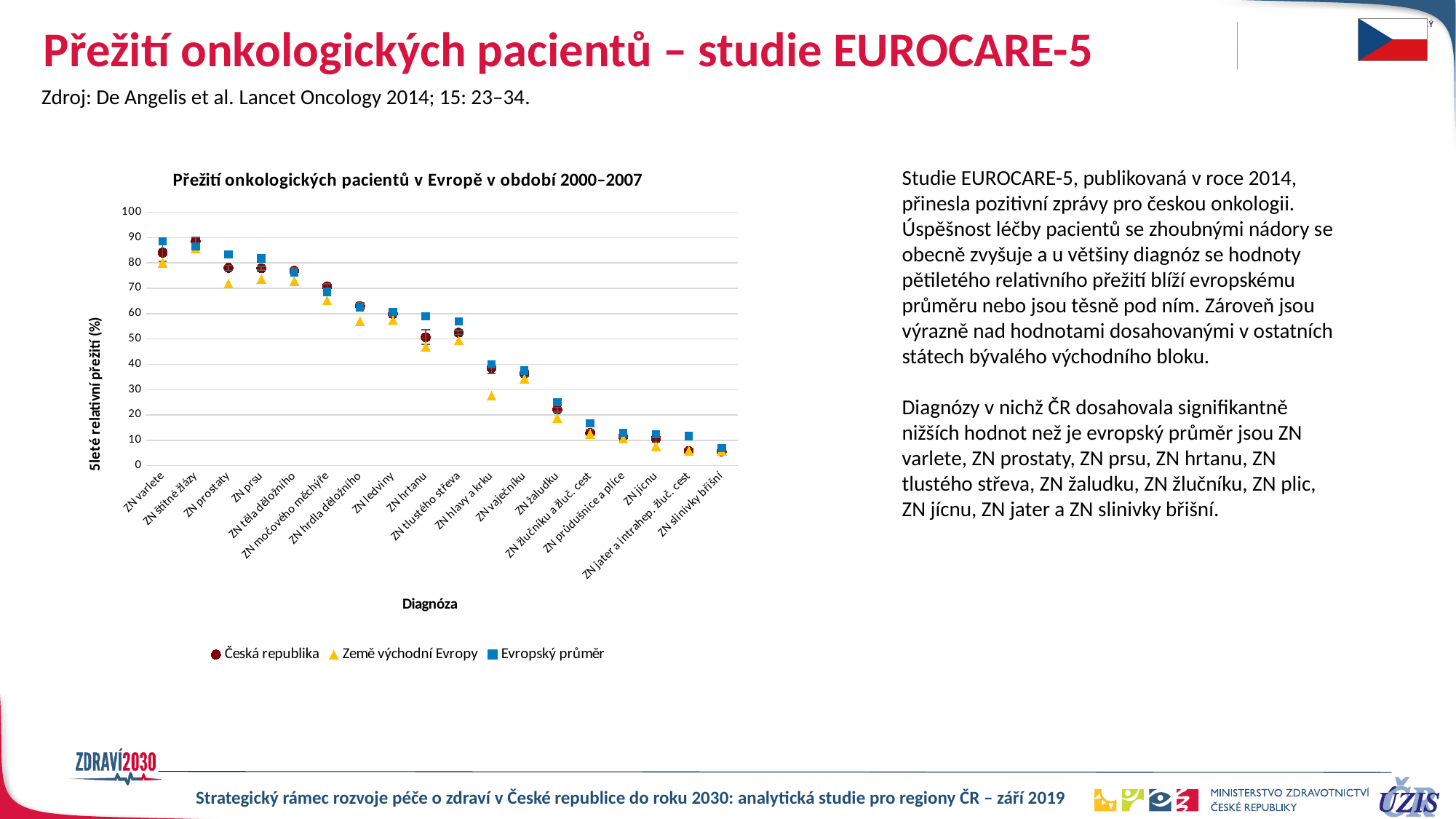
What is the label of the vertical axis of the chart? 5leté relativní přežití (%) For ZN prostaty, which is larger: the value for Evropský průměr or for Země východní Evropy? Evropský průměr Is the Česká republika value for ZN slinivky břišní greater or less than 10? less Do the plotted survival values generally rise or fall from left to right along the x axis? fall Which diagnosis has the lowest value for Evropský průměr? ZN slinivky břišní How many diagnoses (categories) are plotted on the x axis of the chart? 18 What is the title of the chart? Přežití onkologických pacientů v Evropě v období 2000–2007 Which diagnosis has the highest value for Česká republika? ZN štítné žlázy How many series does the legend of the chart list? 3 Is the Evropský průměr value for ZN varlete greater or less than 80? greater Is the Země východní Evropy value for ZN hlavy a krku greater or less than 40? less What kind of chart is shown on the slide? scatter chart